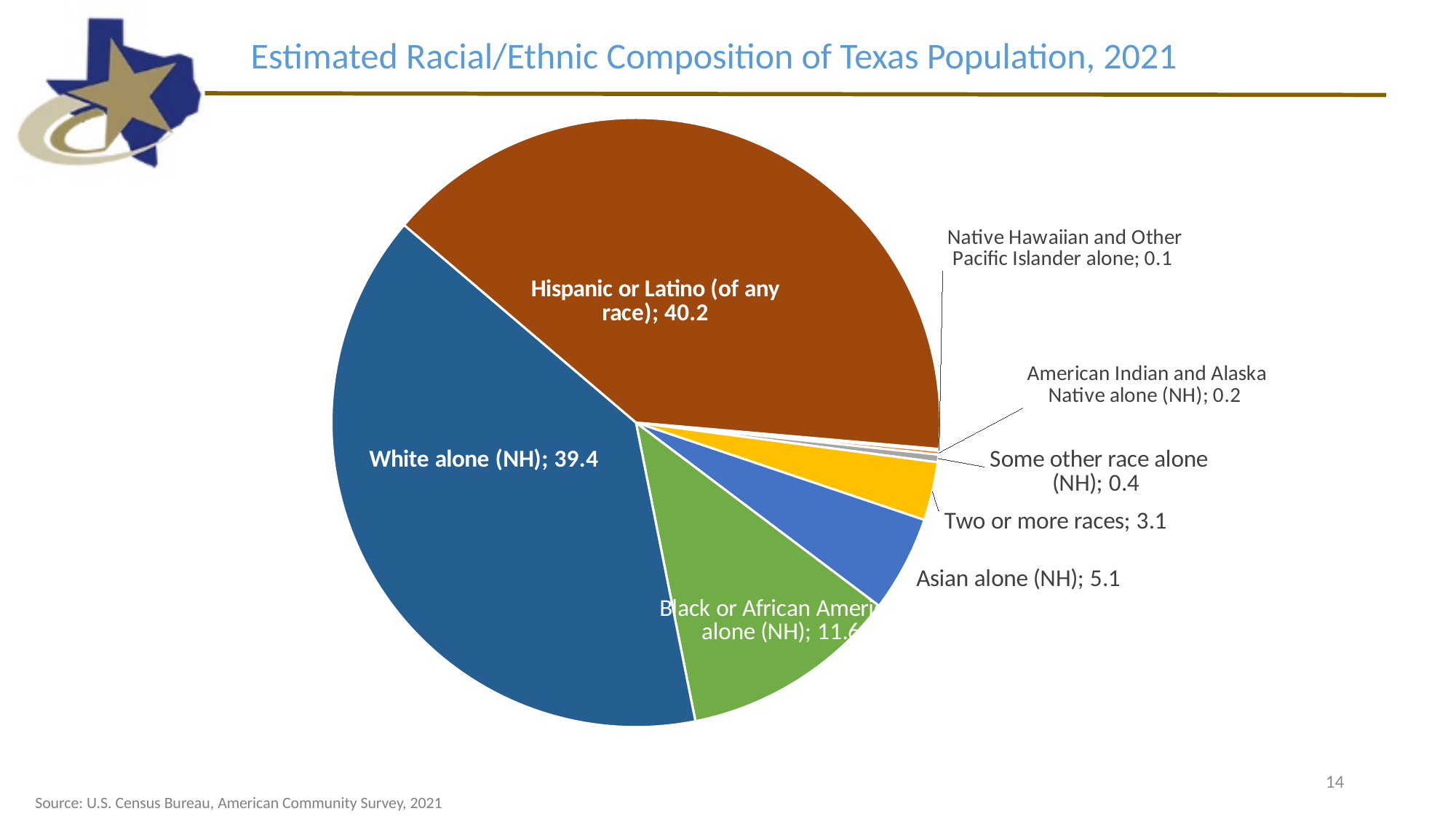
How many categories are shown in the pie chart? 8 Which is larger, the value for Asian alone (NH) or the value for Two or more races? Asian alone (NH) Which category has the smallest slice of the pie? Native Hawaiian and Other Pacific Islander alone What is the difference between the values for Hispanic or Latino (of any race) and White alone (NH)? 0.8 What value is shown for Hispanic or Latino (of any race)? 40.2 What is the title of the chart? Estimated Racial/Ethnic Composition of Texas Population, 2021 What value is shown for White alone (NH)? 39.4 What value is shown for Native Hawaiian and Other Pacific Islander alone? 0.1 What value is shown for Two or more races? 3.1 What type of chart is shown on the slide? Pie chart What value is shown for Asian alone (NH)? 5.1 Which category has the largest slice of the pie? Hispanic or Latino (of any race)